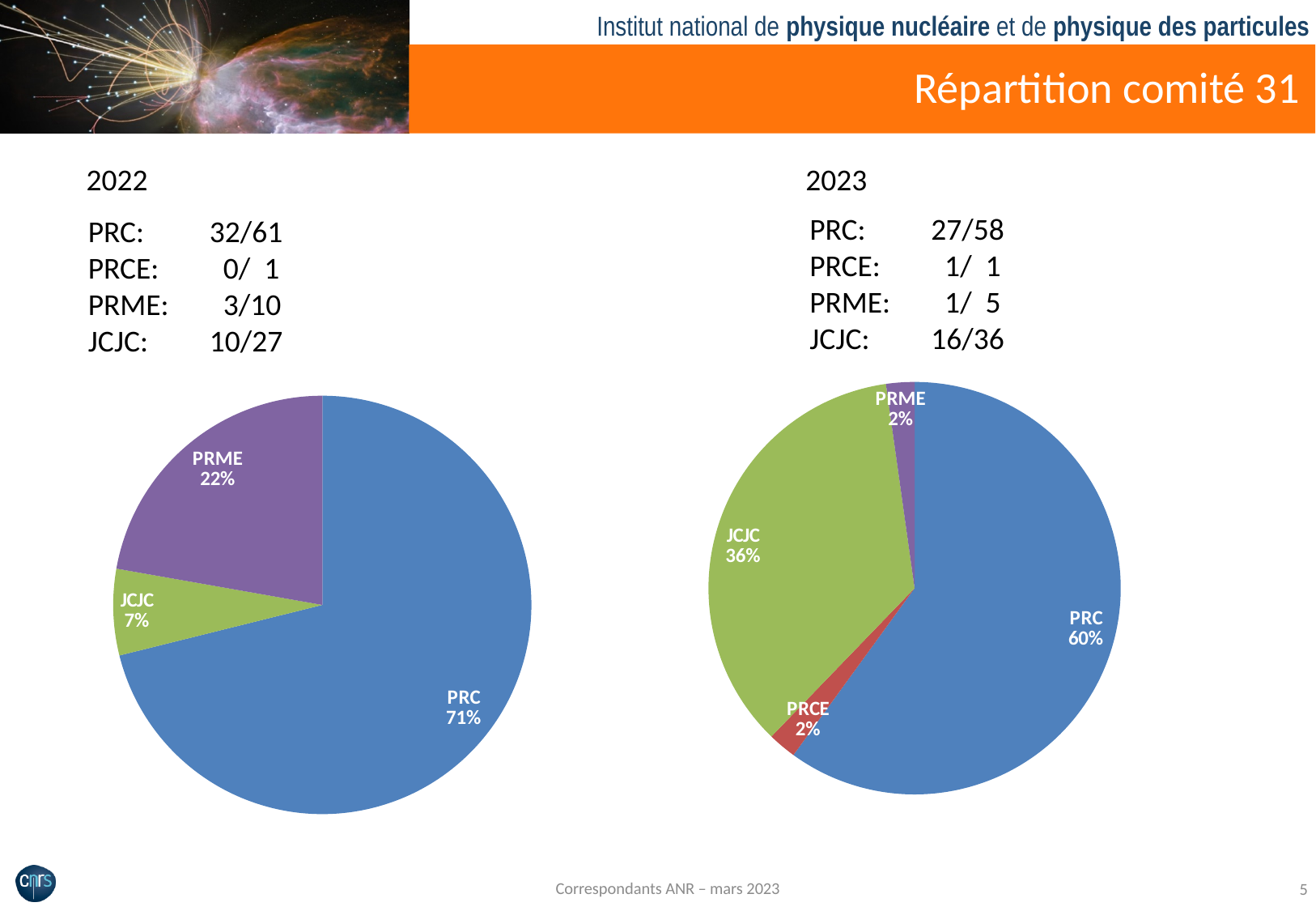
How many slices does the 2023 pie chart on the right have? 4 What type of chart is used to show the 2022 and 2023 distributions? Pie chart In the 2023 pie chart on the right, which category has the largest slice? PRC How many slices does the 2022 pie chart on the left have? 3 In the 2023 pie chart on the right, what share does PRCE have? 2% In the 2022 pie chart on the left, which category has the smallest slice? JCJC In the 2022 pie chart on the left, what share does JCJC have? 7% In the 2022 pie chart on the left, what share does PRME have? 22% In the 2022 pie chart on the left, what share does PRC have? 71% In the 2023 pie chart on the right, what share does JCJC have? 36% What is the difference between the PRC share in the 2022 pie chart and the PRC share in the 2023 pie chart? 11 percentage points Which is larger: the JCJC share in the 2022 pie chart or the JCJC share in the 2023 pie chart? 2023